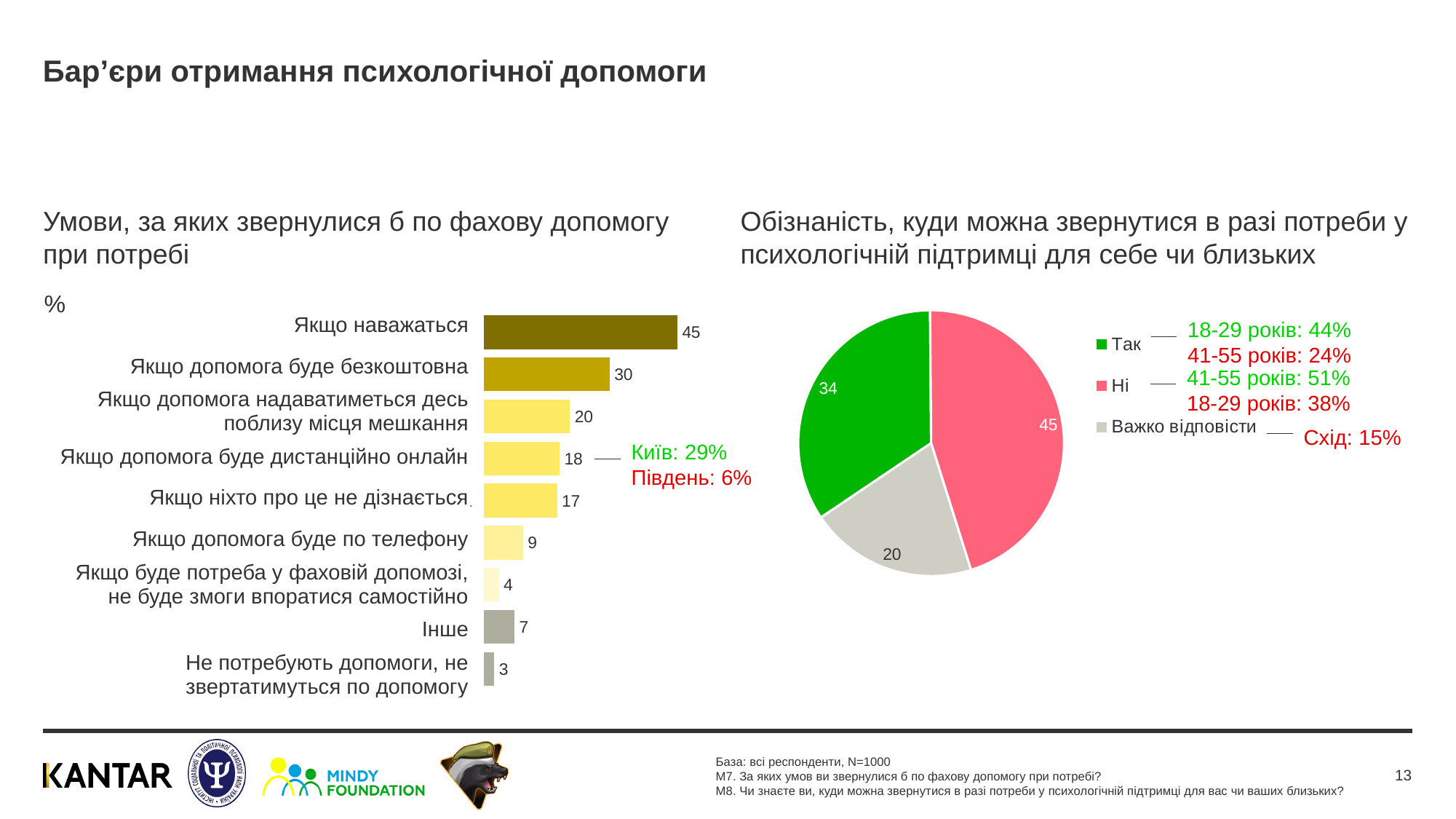
In the pie chart on the right, which slice is the largest? Ні In the bar chart on the left, what is the value for "Якщо наважаться"? 45 How many entries does the legend of the pie chart on the right list? 3 What kind of chart is the chart on the left of the slide? Bar chart How many categories does the bar chart on the left show? 9 In the pie chart on the right, what colour is the "Так" slice? Green In the bar chart on the left, what is the difference between "Якщо наважаться" and "Якщо допомога буде безкоштовна"? 15 In the bar chart on the left, which category has the lowest value? Не потребують допомоги, не звертатимуться по допомогу In the pie chart on the right, what is the value for "Ні"? 45 In the bar chart on the left, what is the value for "Якщо допомога буде по телефону"? 9 In the bar chart on the left, which is larger: "Якщо допомога буде по телефону" or "Інше"? Якщо допомога буде по телефону In the pie chart on the right, what is the difference between "Так" and "Важко відповісти"? 14